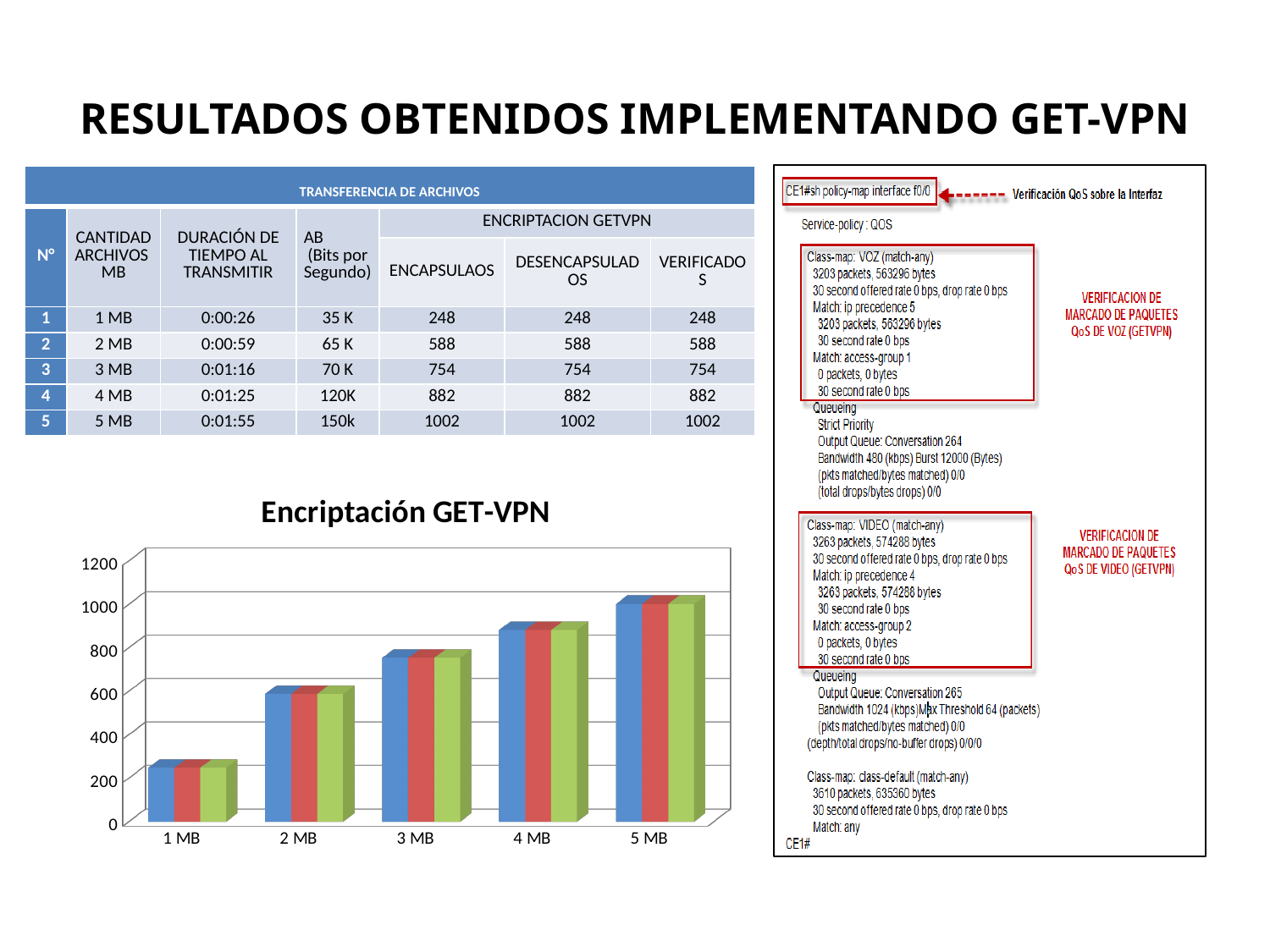
In the "Encriptación GET-VPN" chart, which category has the lowest bars? 1 MB In the "Encriptación GET-VPN" chart, is the value for 4 MB greater or less than 1000? less In the "Encriptación GET-VPN" chart, is the value for 1 MB greater or less than 400? less In the "Encriptación GET-VPN" chart, is the value for 3 MB greater or less than 600? greater What is the title of the chart on the slide? Encriptación GET-VPN What kind of chart is shown under the title "Encriptación GET-VPN"? bar chart In the "Encriptación GET-VPN" chart, which is larger, the value for 2 MB or the value for 4 MB? 4 MB What three colours are used for the bars in the "Encriptación GET-VPN" chart? blue, red and green In the "Encriptación GET-VPN" chart, do the values rise or fall as the file size increases from 1 MB to 5 MB? rise In the "Encriptación GET-VPN" chart, which category has the highest bars? 5 MB How many categories are shown on the x axis of the "Encriptación GET-VPN" chart? 5